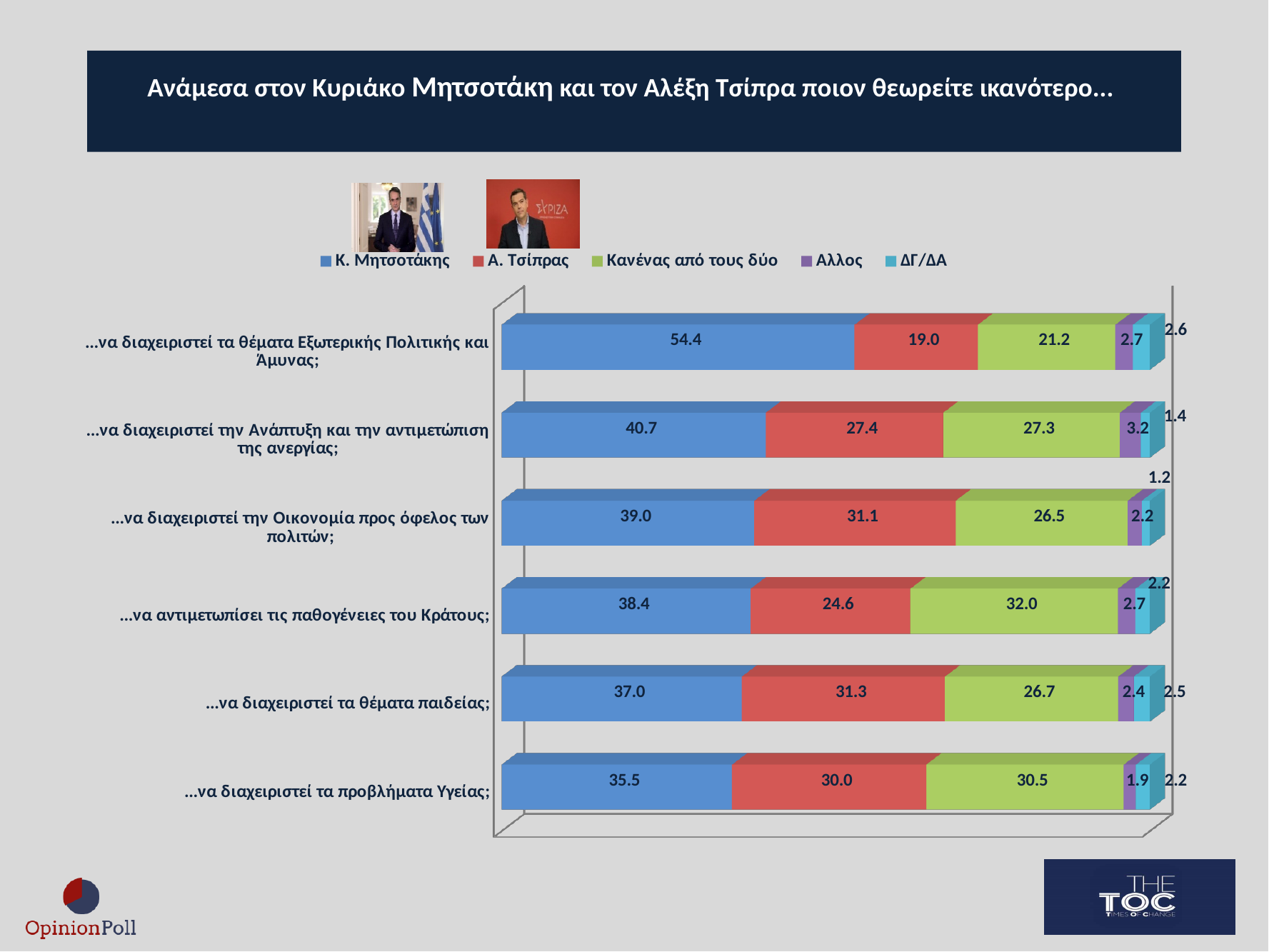
What kind of chart is shown on the slide? Stacked bar chart What is the value for Α. Τσίπρας in the category "...να διαχειριστεί την Οικονομία προς όφελος των πολιτών;"? 31.1 What is the value for Κ. Μητσοτάκης in the category "...να διαχειριστεί τα θέματα Εξωτερικής Πολιτικής και Άμυνας;"? 54.4 In which category does Α. Τσίπρας have the lowest value? ...να διαχειριστεί τα θέματα Εξωτερικής Πολιτικής και Άμυνας; What is the difference between the Κ. Μητσοτάκης and Α. Τσίπρας values in the category "...να διαχειριστεί τα προβλήματα Υγείας;"? 5.5 What is the value for Άλλος in the category "...να διαχειριστεί την Ανάπτυξη και την αντιμετώπιση της ανεργίας;"? 3.2 How many series does the legend list? 5 How many categories (questions) are shown on the chart? 6 What is the value for Κανένας από τους δύο in the category "...να αντιμετωπίσει τις παθογένειες του Κράτους;"? 32.0 In the category "...να διαχειριστεί τα θέματα παιδείας;", which is larger: the value for Α. Τσίπρας or for Κανένας από τους δύο? Α. Τσίπρας Which colour represents ΔΓ/ΔΑ in the legend? Light blue In which category does Κ. Μητσοτάκης have the highest value? ...να διαχειριστεί τα θέματα Εξωτερικής Πολιτικής και Άμυνας;